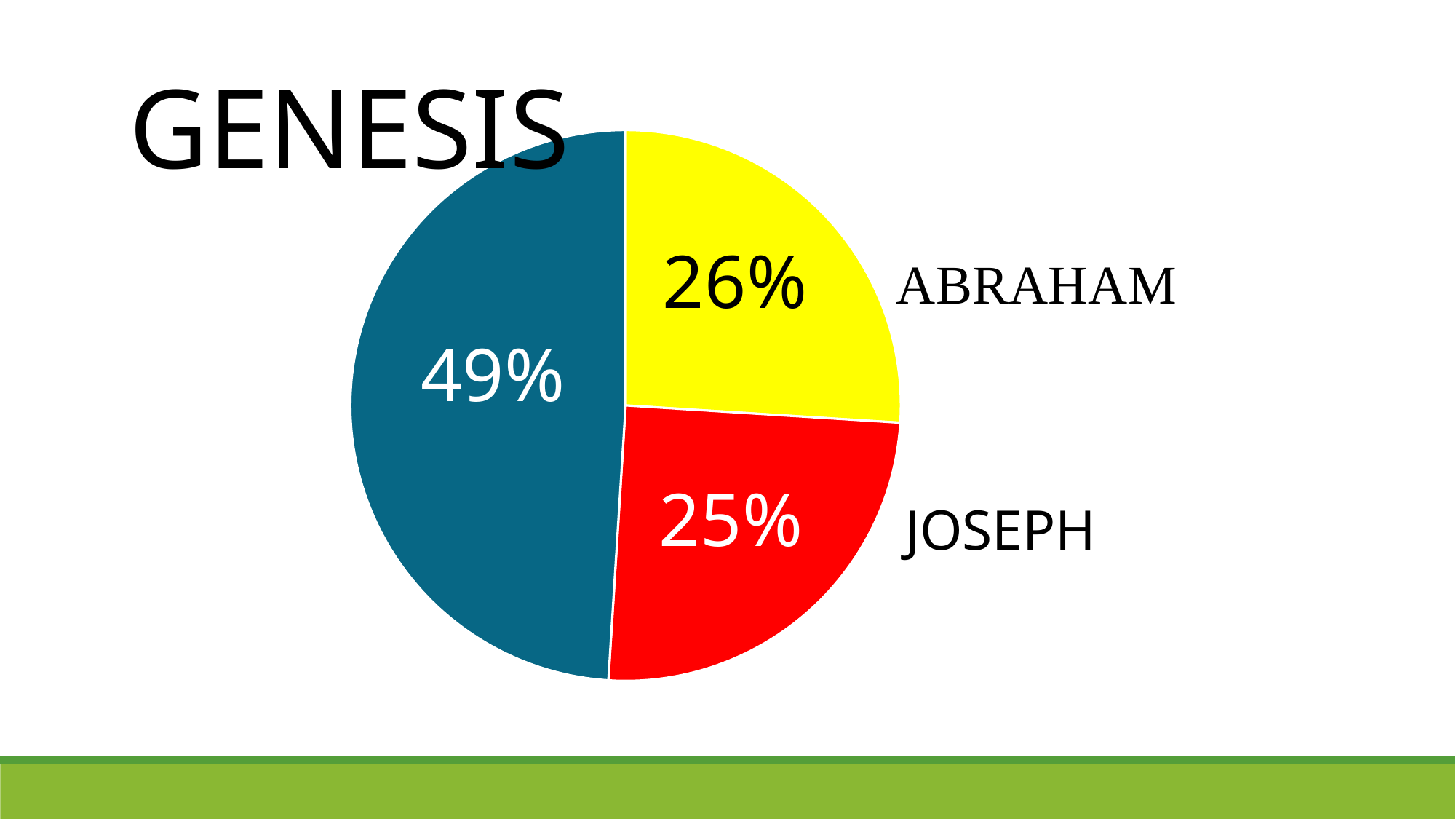
What colour is the slice labelled JOSEPH? red What is the title shown on the slide above the pie chart? GENESIS What kind of chart is shown on the slide? pie chart What percentage of the pie is labelled JOSEPH? 25% Which colour slice is the largest in the pie chart? blue Which labelled slice is the smallest in the pie chart? JOSEPH What is the difference in percentage points between the blue slice and the ABRAHAM slice? 23 What is the difference in percentage points between the ABRAHAM slice and the JOSEPH slice? 1 What percentage of the pie is labelled ABRAHAM? 26% Which is larger, the ABRAHAM slice or the JOSEPH slice? ABRAHAM How many slices does the pie chart have? 3 What percentage is shown on the blue slice of the pie? 49%